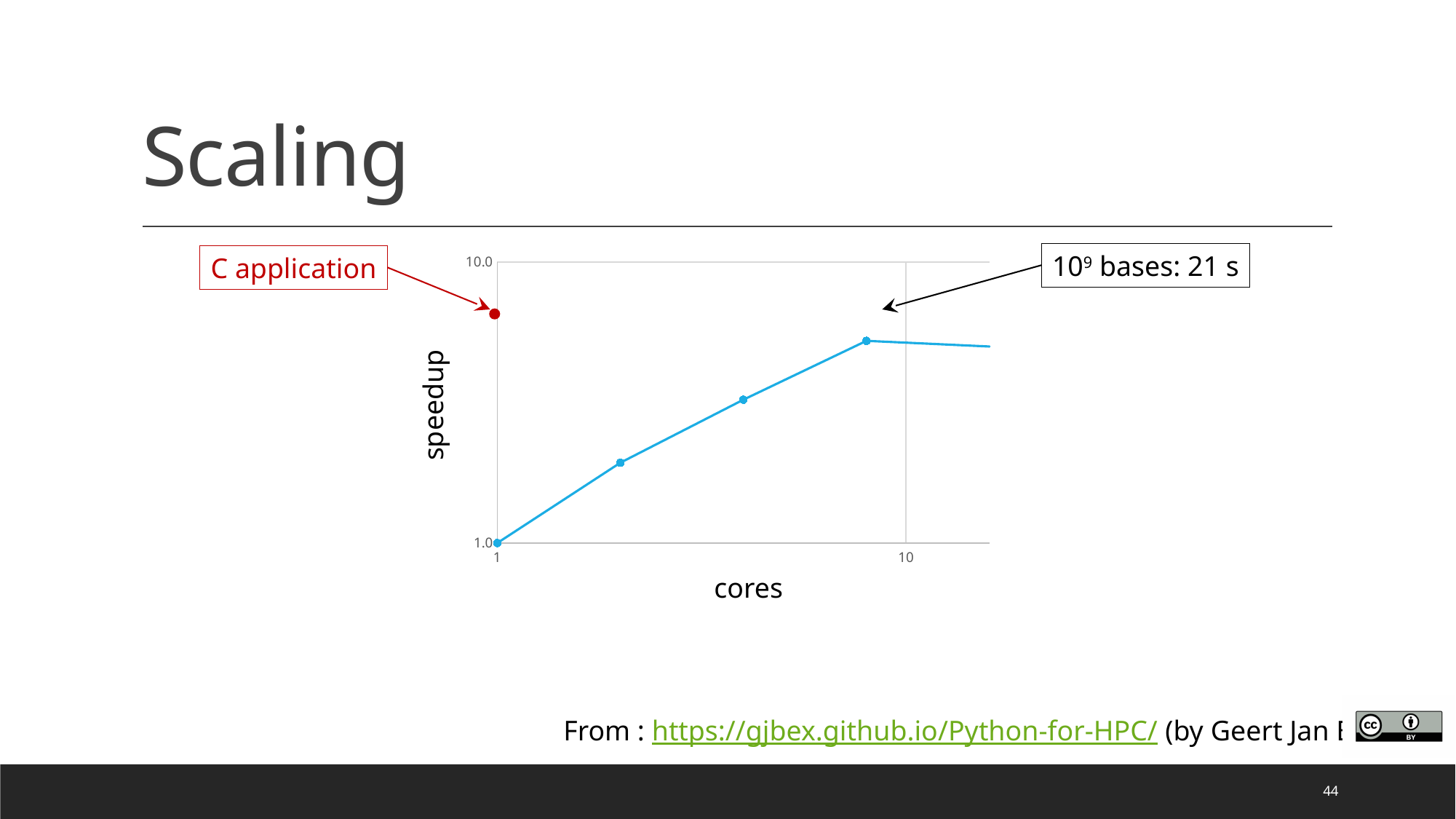
What is the label of the y axis? speedup What kind of chart is shown on the slide? line chart How many marked data points are on the blue line? 4 What is the speedup value of the blue line at 1 core? 1.0 What is the label of the x axis? cores Is the speedup of the red 'C application' point greater or less than 1.0? greater What does the annotation pointing at the highest marked point of the blue line say? 10⁹ bases: 21 s Does the speedup of the blue line rise or fall as the number of cores increases from 1 to 8? rise What is the highest tick value shown on the y axis? 10.0 Is the speedup of the blue line at its highest marked point greater or less than 10.0? less Which is higher at 1 core: the red 'C application' point or the blue line? C application